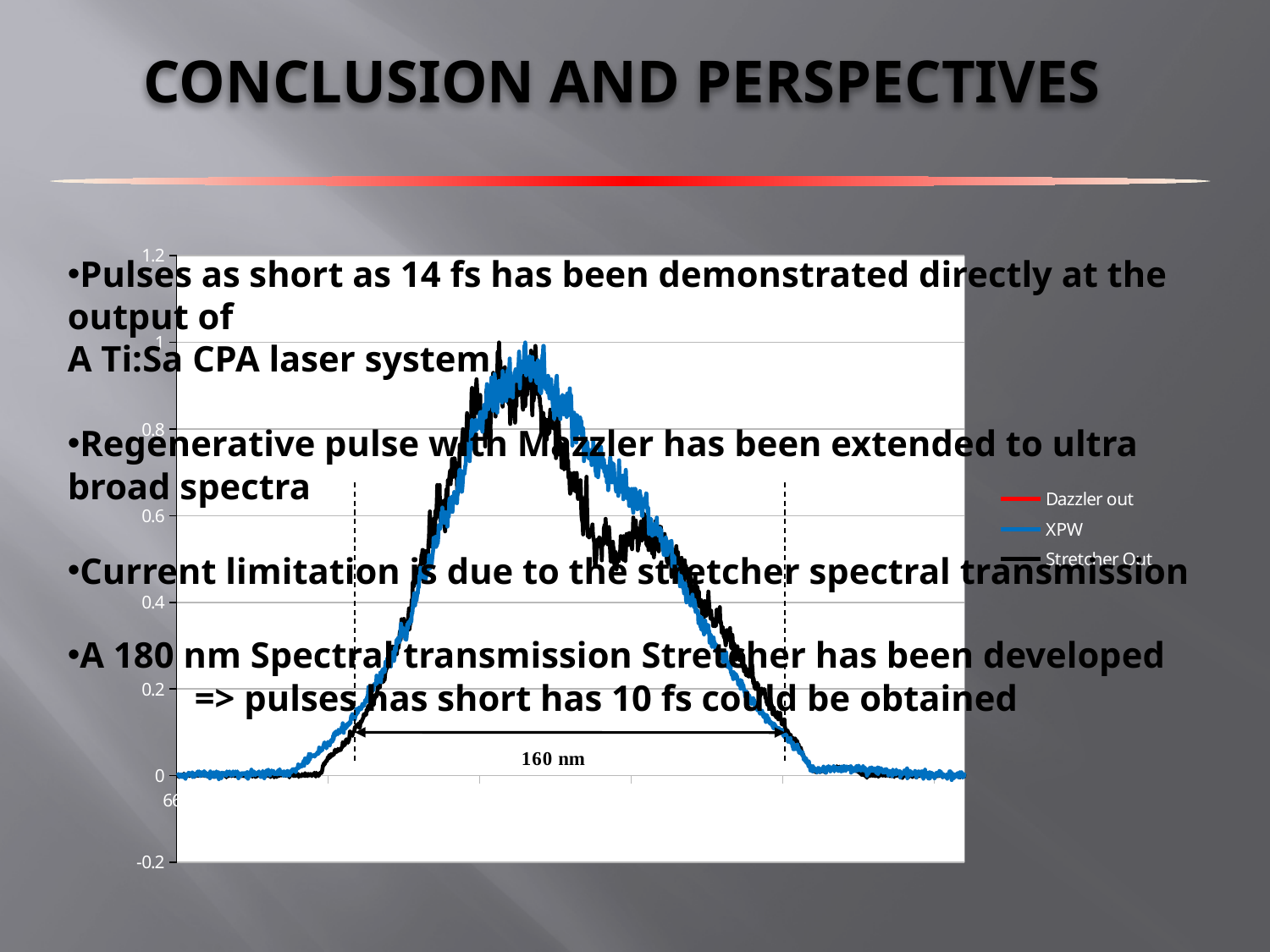
Is the peak value of the XPW series greater or less than 0.8? greater Do the series values rise or fall along the x axis after the peak? fall What spectral width is annotated by the horizontal arrow on the chart? 160 nm Which series is drawn in blue according to the legend? XPW How many series does the chart legend list? 3 What is the highest tick value shown on the vertical axis? 1.2 Is the peak value of the XPW series greater or less than 1.2? less Is the peak value of the Stretcher Out series greater or less than 0.6? greater What kind of chart is shown on the slide? line chart What is the lowest tick value shown on the vertical axis? -0.2 Which series is drawn in black according to the legend? Stretcher Out